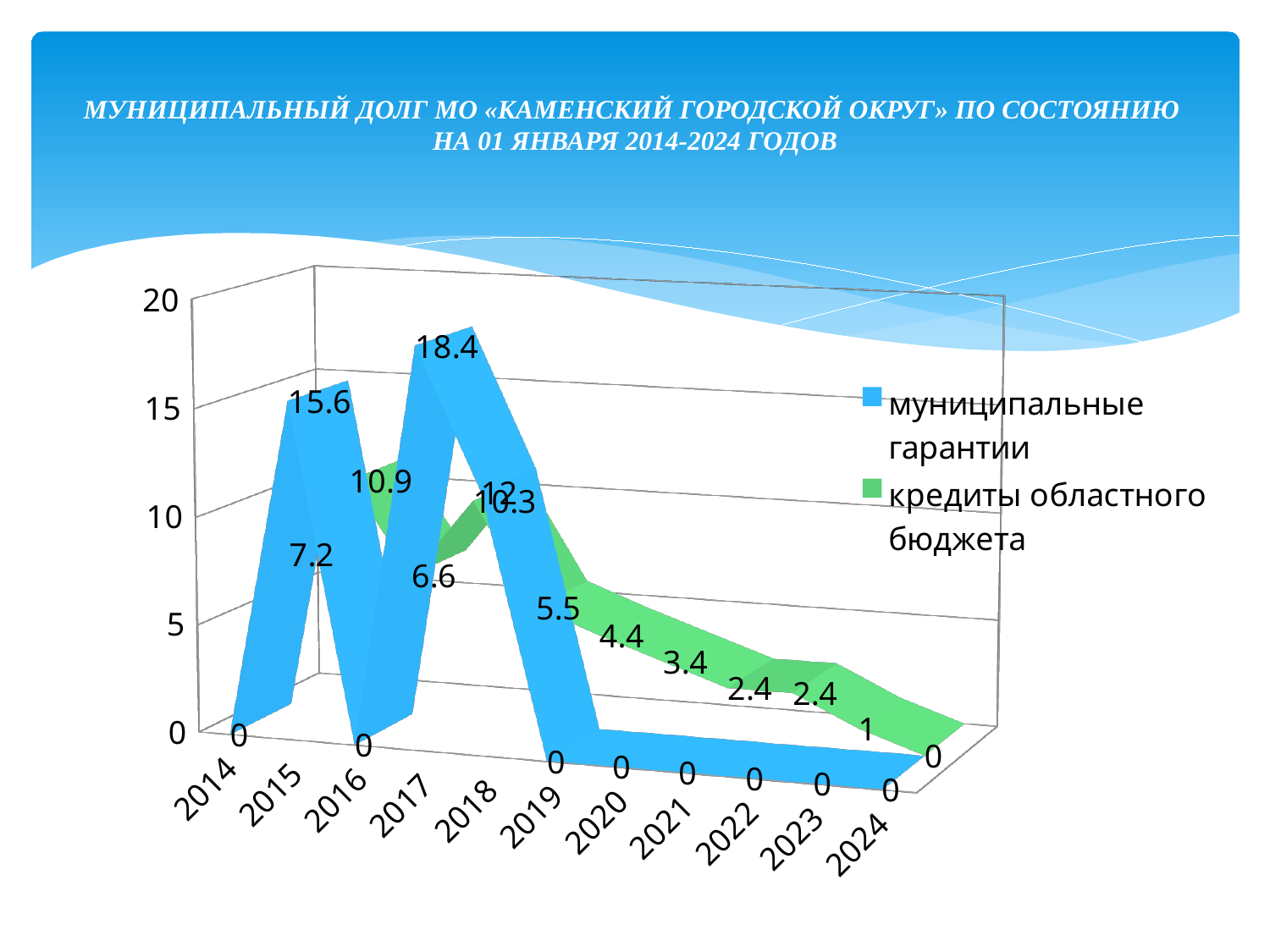
How many years are shown on the x axis? 11 What is the highest value labelled on the кредиты областного бюджета series? 10.9 What is the value of муниципальные гарантии in 2017? 18.4 What is the value of муниципальные гарантии in 2014? 0 In which year does муниципальные гарантии reach its highest value? 2017 What is the difference between the муниципальные гарантии values in 2017 and 2015? 2.8 How many series does the legend list? 2 What is the value of муниципальные гарантии in 2020? 0 Is the value of муниципальные гарантии in 2017 greater or less than 15? greater Which is larger for муниципальные гарантии: the value in 2015 or in 2017? 2017 What kind of chart is shown on the slide? line chart What is the value of муниципальные гарантии in 2015? 15.6